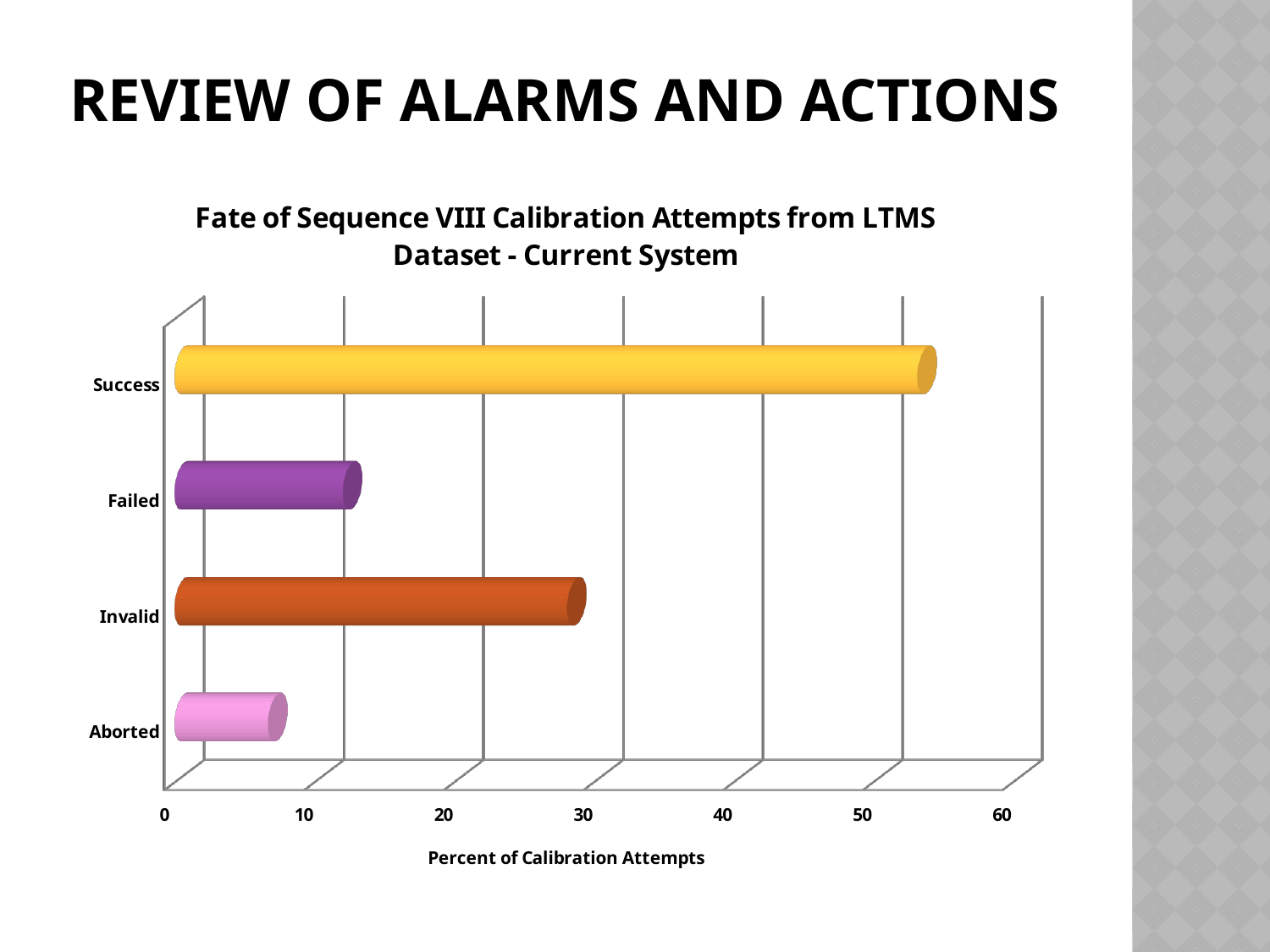
What is the label of the horizontal axis? Percent of Calibration Attempts Which category has the lowest percent of calibration attempts? Aborted Which is larger, the value for Invalid or the value for Failed? Invalid Is the value for Failed greater or less than 10? greater How many categories are plotted in the chart? 4 Which is larger, the value for Failed or the value for Aborted? Failed What kind of chart is shown on the slide? Bar chart Which category has the highest percent of calibration attempts? Success Is the value for Success greater or less than 50? greater Is the value for Aborted greater or less than 10? less What is the title of the chart? Fate of Sequence VIII Calibration Attempts from LTMS Dataset - Current System